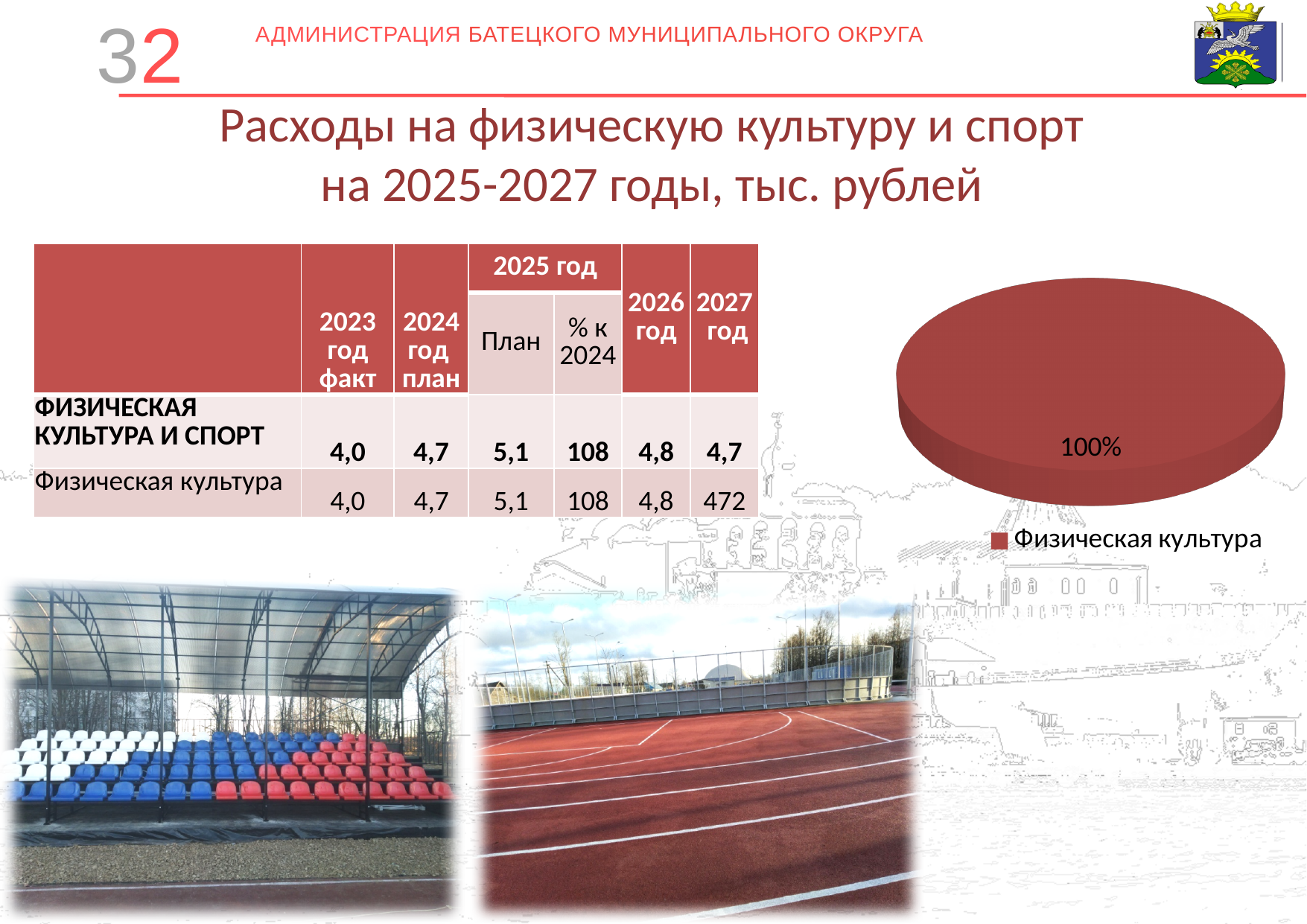
How many entries does the legend of the pie chart list? 1 How many slices does the pie chart have? 1 What colour is the slice for Физическая культура in the pie chart? red What percentage label is printed on the pie chart? 100% What kind of chart is shown on the slide? pie chart What share of the pie chart does Физическая культура account for? 100% What is the name of the category shown in the pie chart's legend? Физическая культура